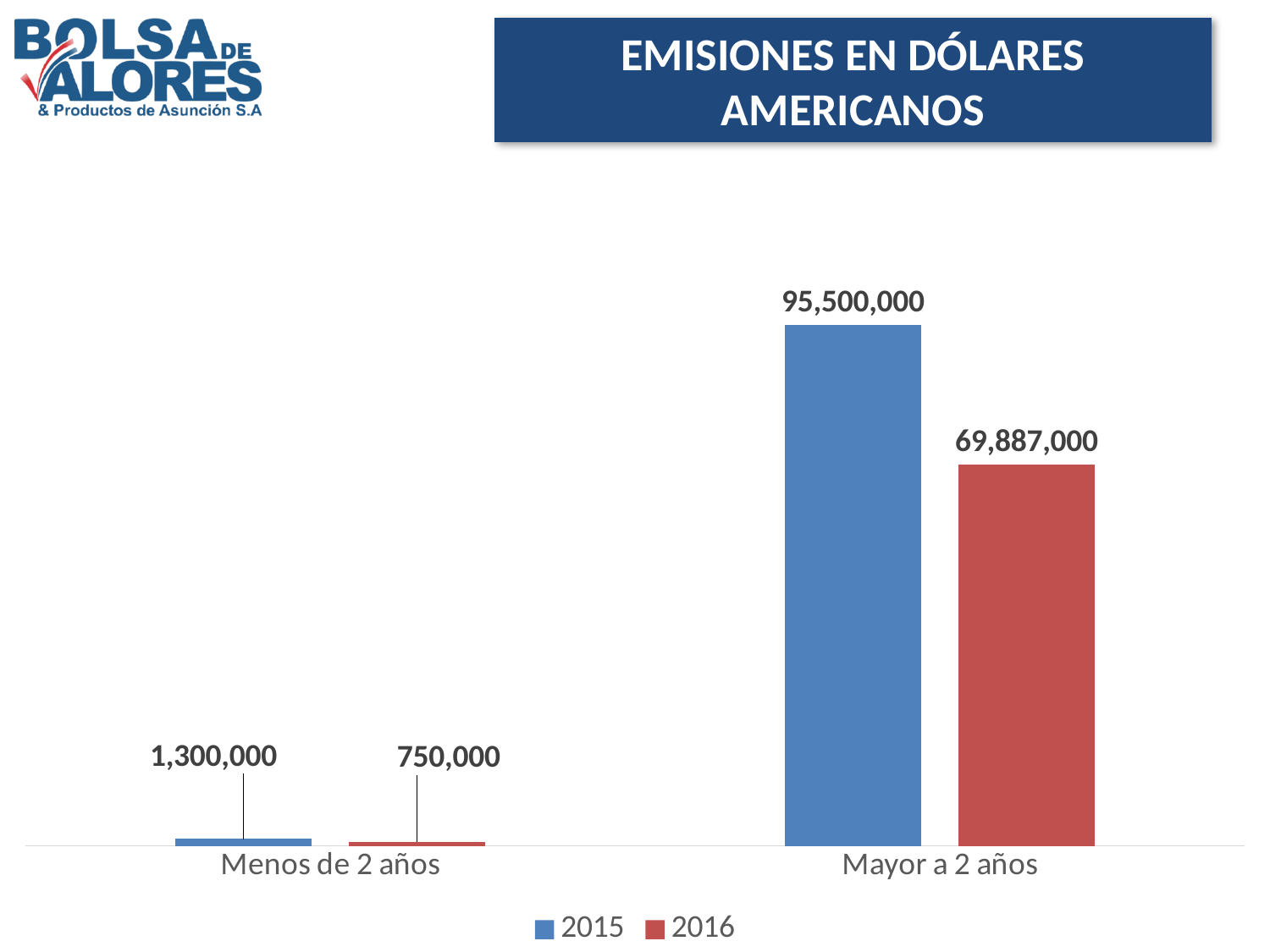
Which is larger for 'Menos de 2 años': the 2015 value or the 2016 value? 2015 What kind of chart is shown on the slide? Bar chart Which bar has the highest value on the chart? 2015, Mayor a 2 años What is the value for 2015 in the 'Menos de 2 años' category? 1,300,000 How many categories are shown on the x axis? 2 What is the value for 2015 in the 'Mayor a 2 años' category? 95,500,000 What is the value for 2016 in the 'Menos de 2 años' category? 750,000 What is the difference between the 2015 and 2016 values for 'Mayor a 2 años'? 25,613,000 What is the value for 2016 in the 'Mayor a 2 años' category? 69,887,000 What is the difference between the 2015 and 2016 values for 'Menos de 2 años'? 550,000 Which bar has the lowest value on the chart? 2016, Menos de 2 años How many series does the legend list? 2